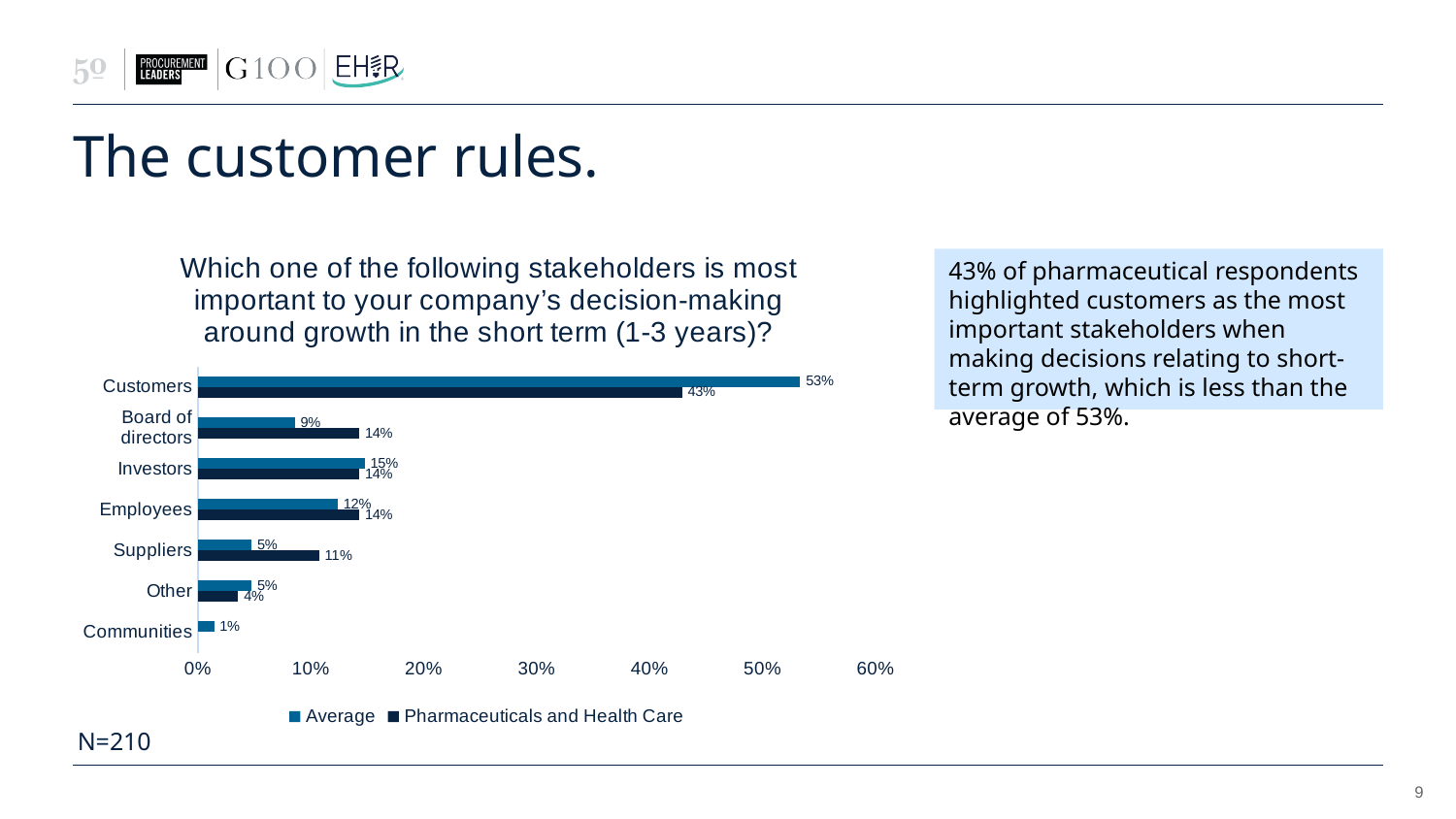
What kind of chart is shown on the slide? Bar chart What is the Pharmaceuticals and Health Care value for Suppliers? 11% What is the difference between the Average and Pharmaceuticals and Health Care values for Customers? 10% How many series does the legend list? 2 How many stakeholder categories are shown on the chart? 7 Is the Average value for Customers greater or less than 50%? greater What is the Average value for Customers? 53% For Board of directors, which is larger: the Average value or the Pharmaceuticals and Health Care value? Pharmaceuticals and Health Care What is the Average value for Board of directors? 9% Which stakeholder has the lowest Average value? Communities What is the Pharmaceuticals and Health Care value for Customers? 43% Which stakeholder has the highest Average value? Customers